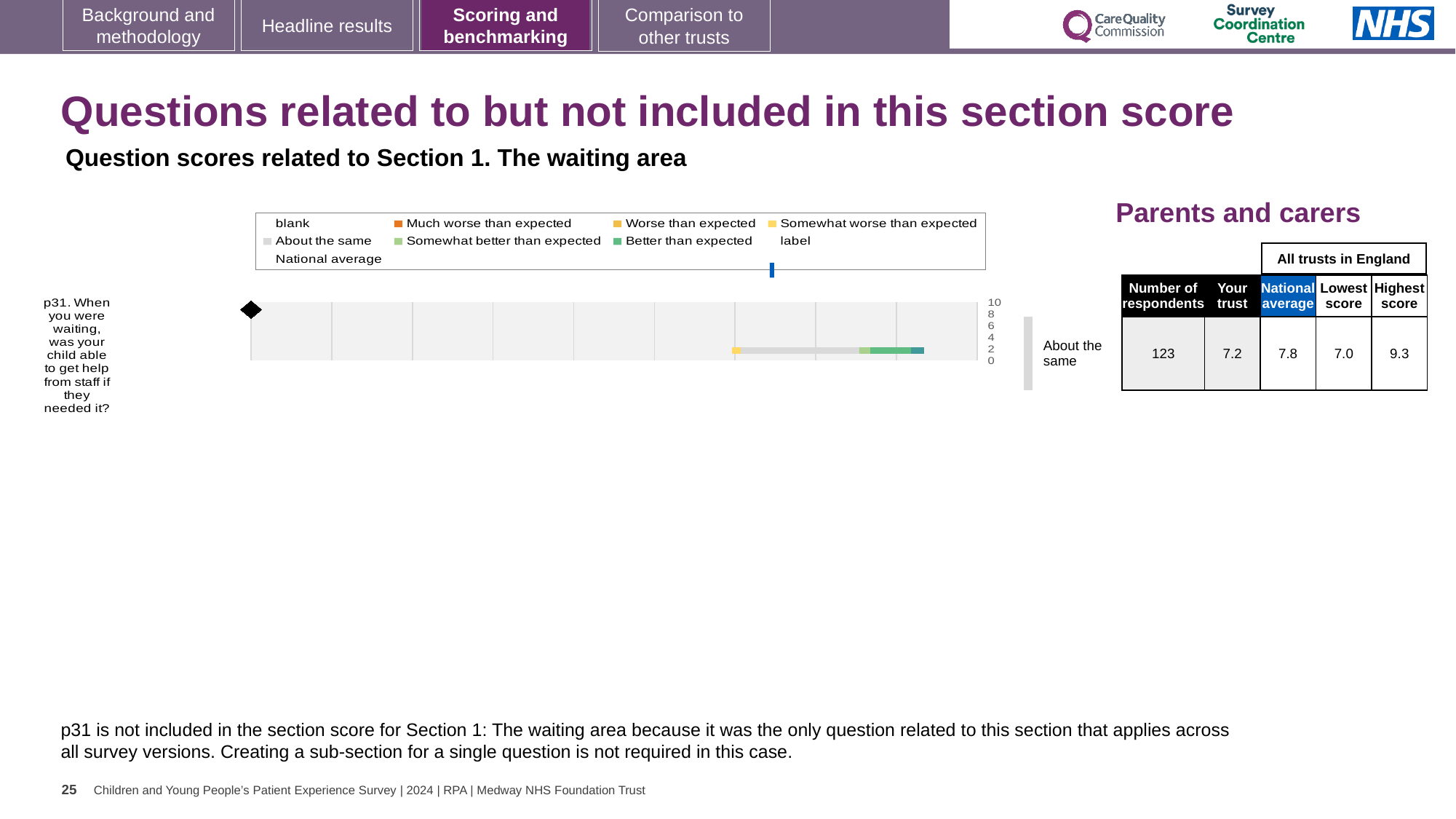
According to the table beside the chart, what is the highest score among all trusts in England for p31? 9.3 Which is larger for p31: the 'Your trust' score or the national average? National average According to the table beside the chart, how many respondents answered p31? 123 According to the table beside the chart, what is the national average score for p31? 7.8 According to the table beside the chart, what is the lowest score among all trusts in England for p31? 7.0 How many questions (categories) are plotted in the chart? 1 What kind of chart is shown on the slide for question p31? bar chart What is the difference between the national average (7.8) and the 'Your trust' score (7.2) for p31? 0.6 How many entries does the chart legend list? 9 Which legend entry is shown in orange? Much worse than expected What benchmark category label is shown to the right of the p31 bar? About the same According to the table beside the chart, what is the 'Your trust' score for p31? 7.2